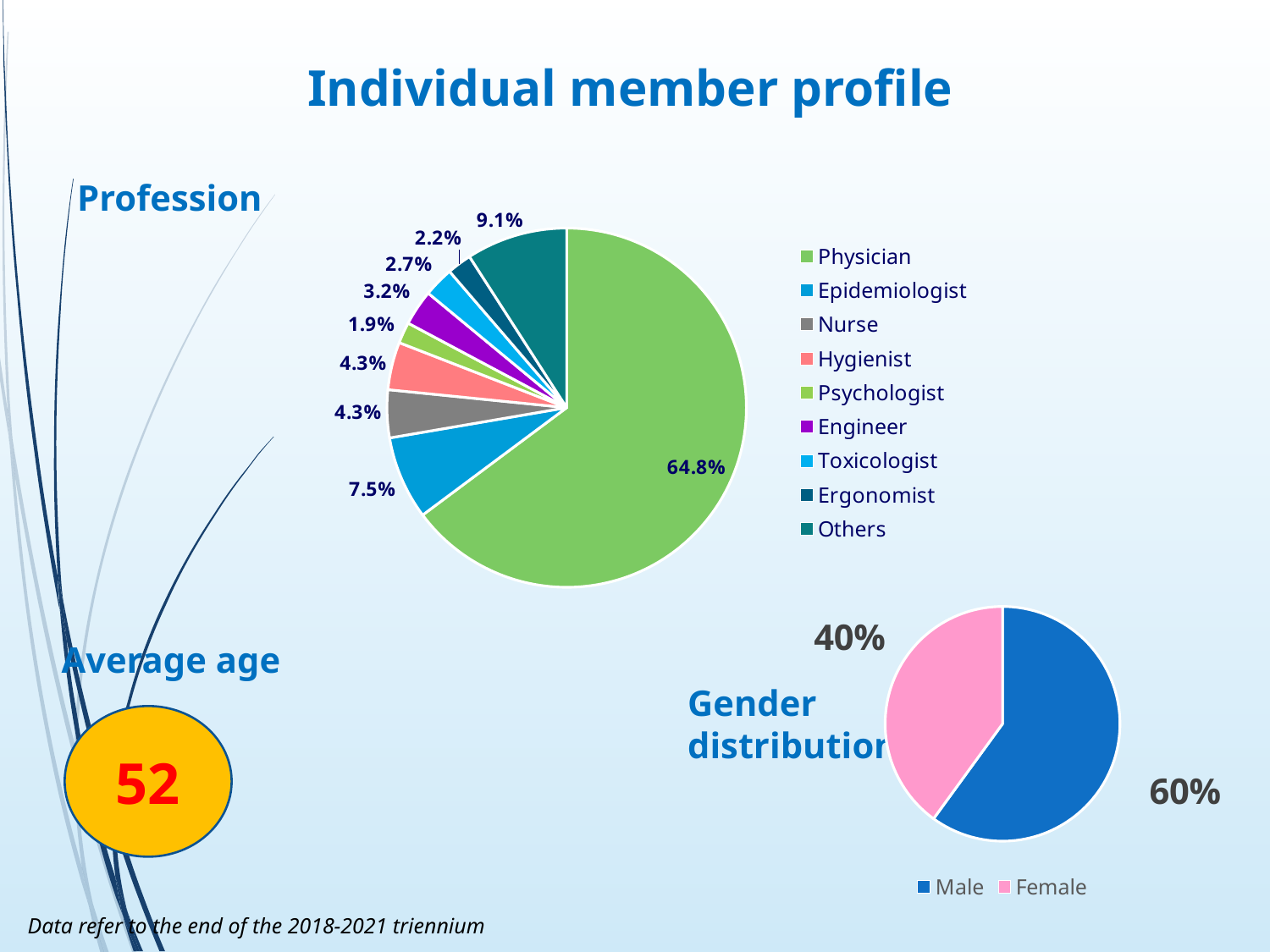
In the Profession pie chart, what share is labelled for Others? 9.1% In the Profession pie chart, what is the difference between the Engineer share and the Toxicologist share? 0.5% In the Profession pie chart, what percentage of members are Epidemiologists? 7.5% In the Profession pie chart, which profession has the smallest share? Psychologist In the Profession pie chart, which profession has the largest share? Physician How many professions are listed in the legend of the Profession pie chart? 9 In the Gender distribution chart, what is the difference between the Male and Female shares? 20% In the Gender distribution chart, what colour represents Female? Pink In the Profession pie chart, which is larger, the Ergonomist share or the Toxicologist share? Toxicologist What type of chart is used for the Profession data? Pie chart In the Gender distribution chart, what percentage of members are Male? 60% In the Profession pie chart, what percentage of members are Physicians? 64.8%